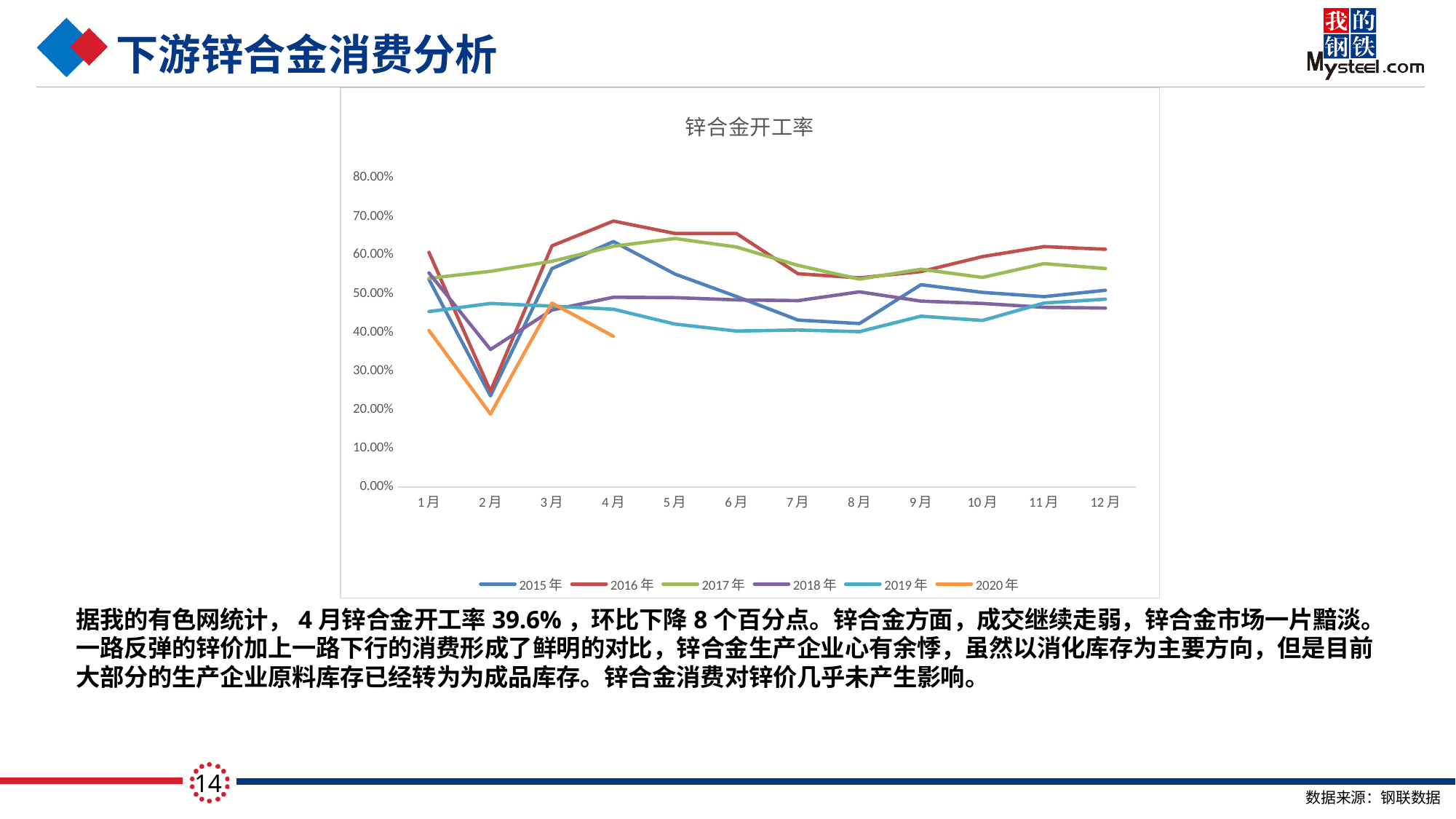
What kind of chart is shown on the slide? line chart In 6月, which is larger: the value for 2016年 or the value for 2019年? 2016年 Is the value for 2020年 in 2月 greater or less than 30.00%? less How many series does the legend list? 6 In which month does the 2020年 series reach its lowest value? 2月 Which series is drawn in orange? 2020年 Is the value for 2019年 in 6月 greater or less than 50.00%? less In which month does the 2016年 series reach its highest value? 4月 What is the title of the chart? 锌合金开工率 Which series has the highest value in 4月? 2016年 How many months are shown on the x axis? 12 Is the value for 2016年 in 4月 greater or less than 60.00%? greater